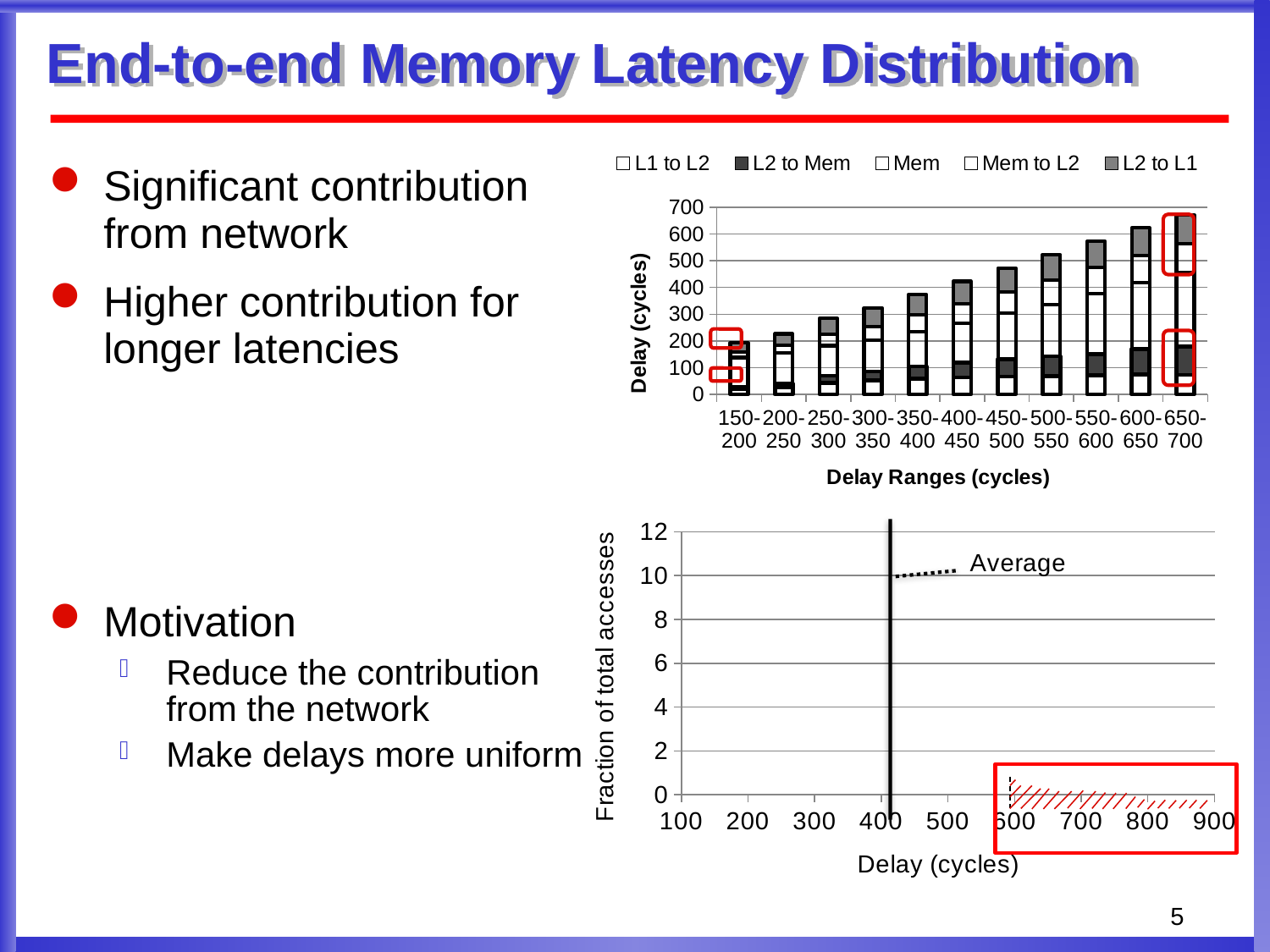
In the top chart, is the total for the 650-700 delay range greater or less than 600? greater What is the y-axis label of the bottom chart? Fraction of total accesses In the top chart, do the total bar heights rise or fall as you move from left to right along the x axis? rise How many series does the legend of the top chart list? 5 In the top chart, which delay range has the lowest total stacked bar? 150-200 What is the first entry in the legend of the top chart? L1 to L2 In the top chart, is the total for the 200-250 delay range greater or less than 300? less How many delay-range categories are shown on the x axis of the top chart? 11 What kind of chart is the top chart on the slide? stacked bar chart In the top chart, is the total for the 550-600 delay range greater or less than 500? greater In the top chart, which has the larger total bar: the 600-650 range or the 300-350 range? 600-650 In the top chart, which delay range has the highest total stacked bar? 650-700